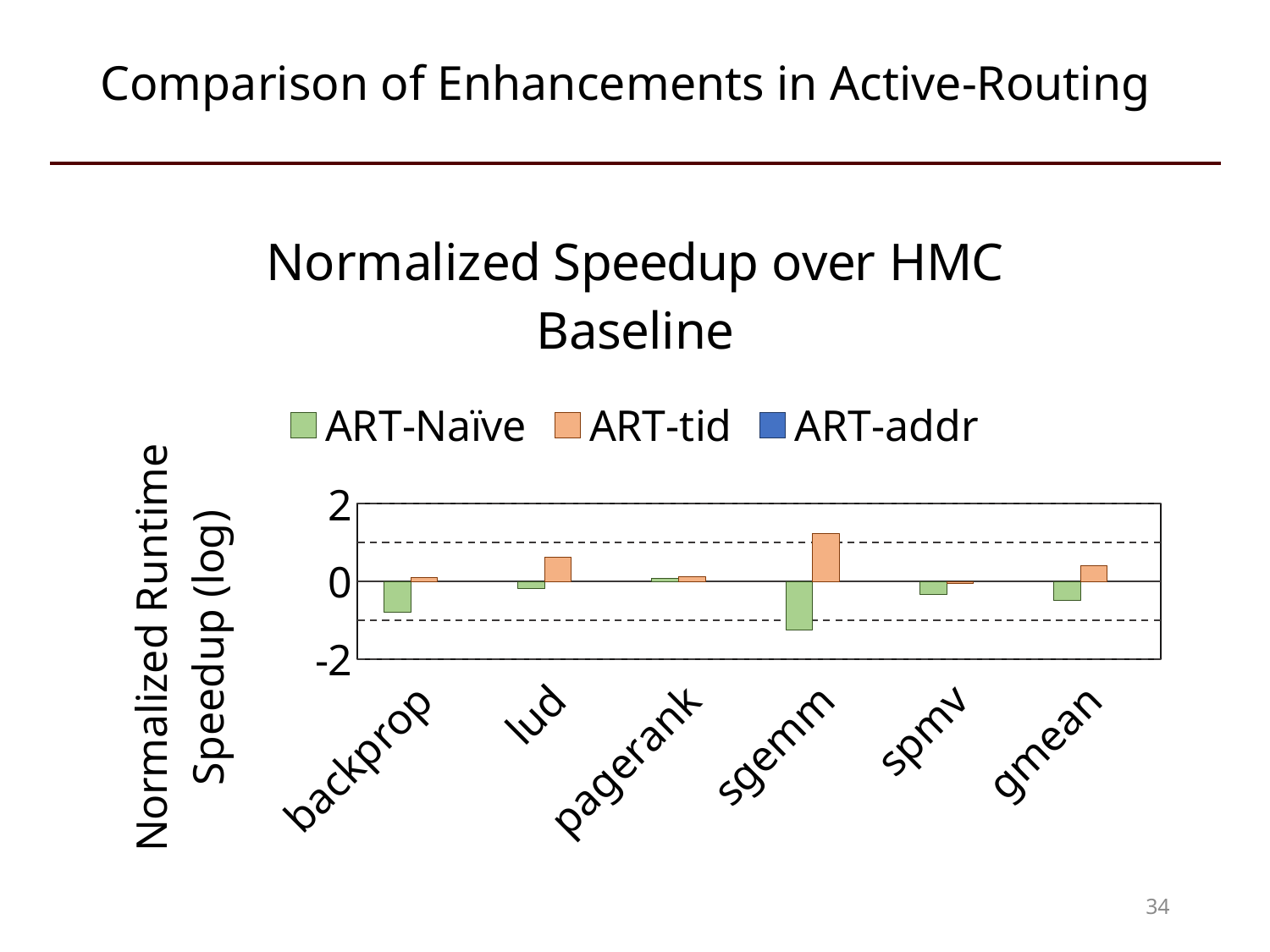
What is the title of the chart? Normalized Speedup over HMC Baseline How many categories are shown on the x axis? 6 For backprop, which series has the larger value, ART-Naïve or ART-tid? ART-tid Which category has the lowest ART-Naïve value? sgemm How many series does the legend list? 3 Which category has the highest ART-tid value? sgemm Which is larger, the ART-tid value for lud or the ART-tid value for gmean? lud Is the ART-tid value for lud greater or less than 0? greater What colour represents the ART-Naïve series in the legend? green Is the ART-Naïve value for backprop greater or less than 0? less What kind of chart is shown on the slide? bar chart Which is lower, the ART-Naïve value for backprop or the ART-Naïve value for sgemm? sgemm